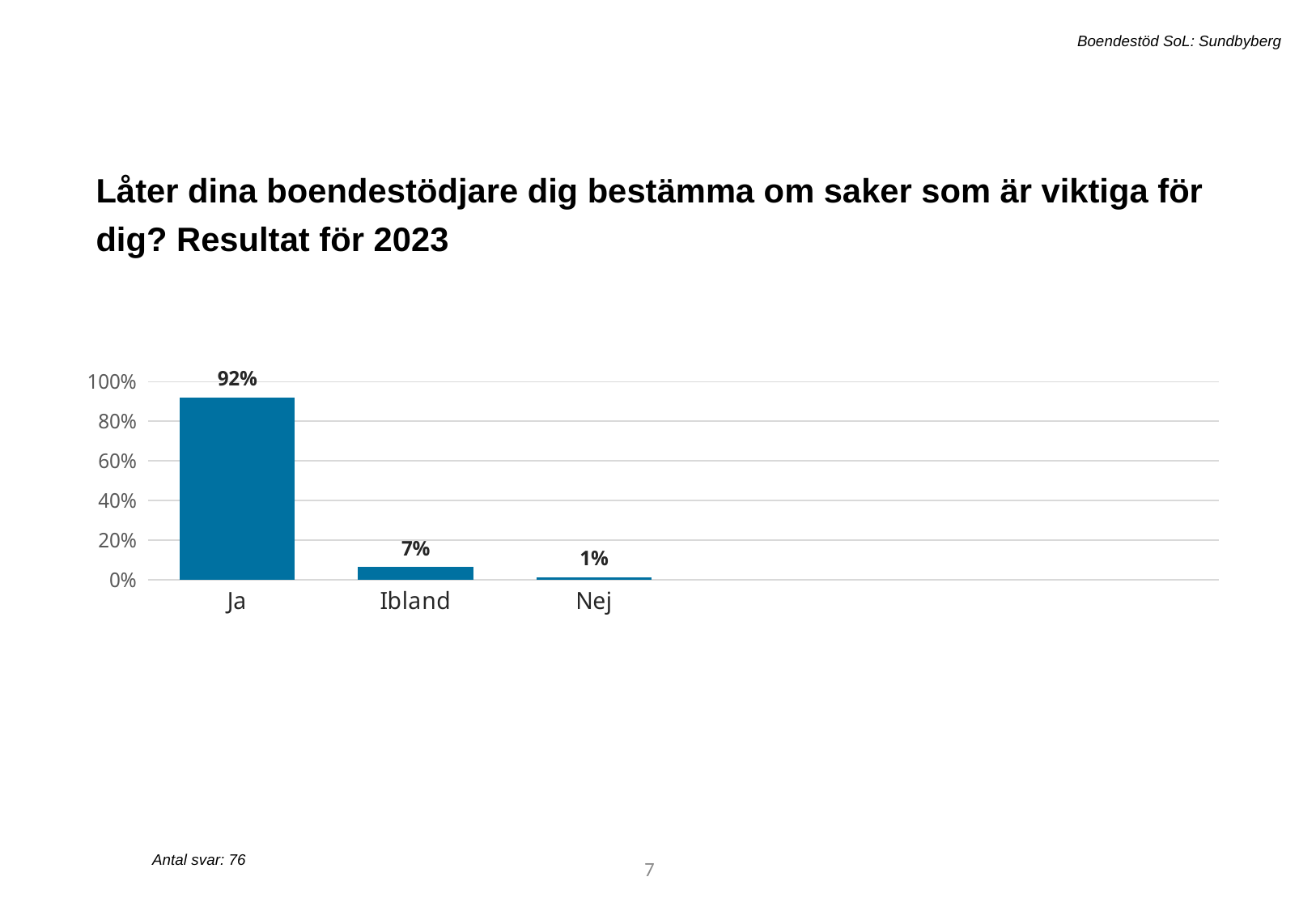
What kind of chart is shown on the slide? bar chart What is the difference between the values for Ibland and Nej? 6% Is the value for Ja greater or less than 80%? greater Which category has the highest value? Ja How many categories are shown on the x axis? 3 How many responses (Antal svar) does the slide report? 76 What is the difference between the values for Ja and Ibland? 85% What is the value for Nej? 1% Which is larger, the value for Ibland or the value for Nej? Ibland What is the value for Ibland? 7% Which category has the lowest value? Nej What is the value for Ja? 92%